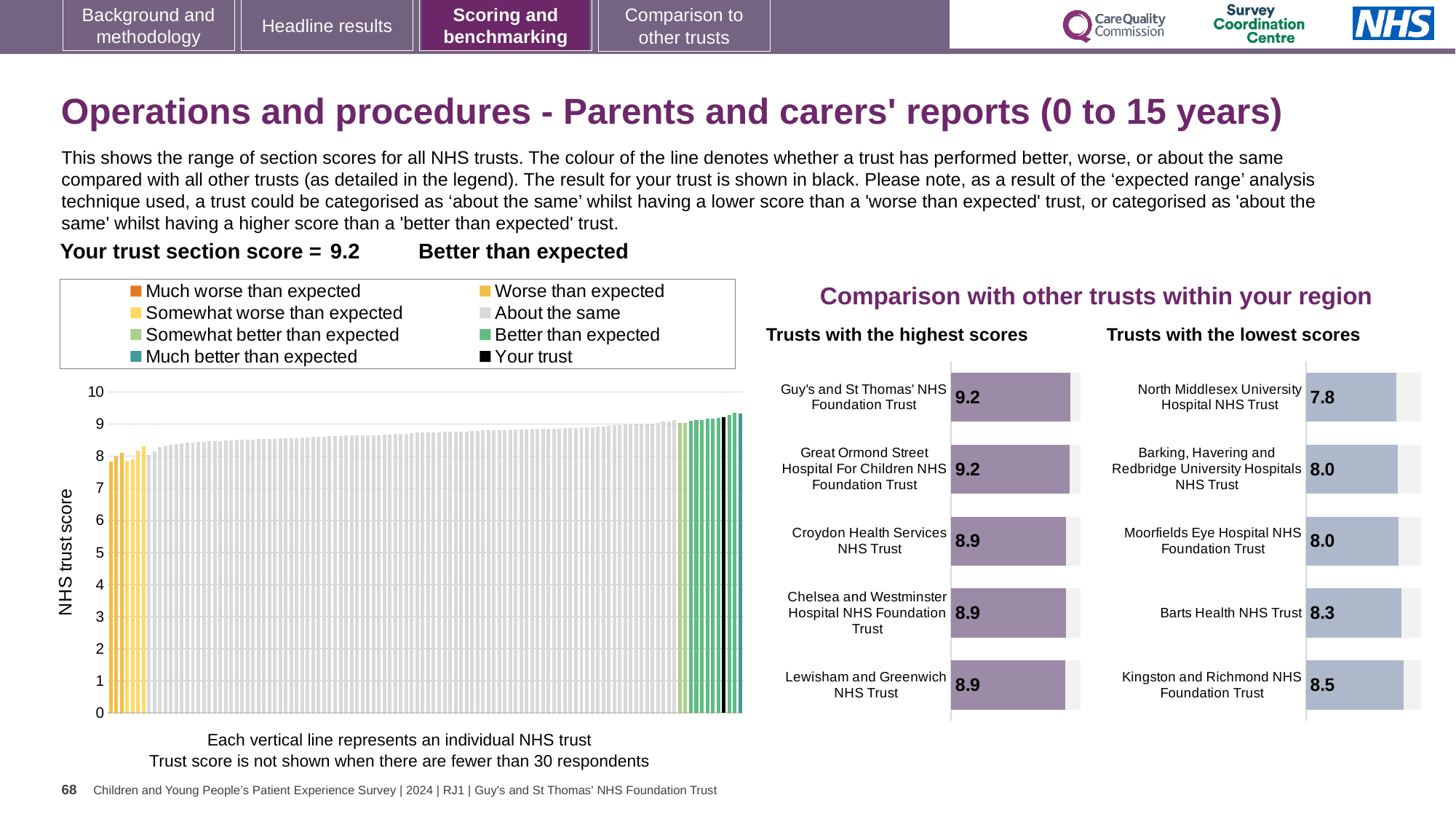
In the 'Trusts with the highest scores' chart, what is the score for Croydon Health Services NHS Trust? 8.9 Which is larger: the score for Great Ormond Street Hospital For Children NHS Foundation Trust in the highest scores chart, or the score for Barts Health NHS Trust in the lowest scores chart? Great Ormond Street Hospital For Children NHS Foundation Trust In the 'Trusts with the highest scores' chart, what is the difference between the scores of Guy's and St Thomas' NHS Foundation Trust and Lewisham and Greenwich NHS Trust? 0.3 In the main 'NHS trust score' chart, do the bar values rise or fall from left to right? rise In the 'Trusts with the lowest scores' chart, what is the score for Barts Health NHS Trust? 8.3 How many trusts are listed in the 'Trusts with the highest scores' chart? 5 In the 'Trusts with the lowest scores' chart, which trust has the lowest score? North Middlesex University Hospital NHS Trust In the 'Trusts with the lowest scores' chart, which trust has the highest score? Kingston and Richmond NHS Foundation Trust What kind of chart is the main chart with the 'NHS trust score' axis? bar chart In the main 'NHS trust score' chart, is the value for the leftmost yellow bar greater or less than 9? less How many entries does the legend of the main 'NHS trust score' chart list? 8 In the 'Trusts with the lowest scores' chart, what is the difference between the scores of Kingston and Richmond NHS Foundation Trust and North Middlesex University Hospital NHS Trust? 0.7